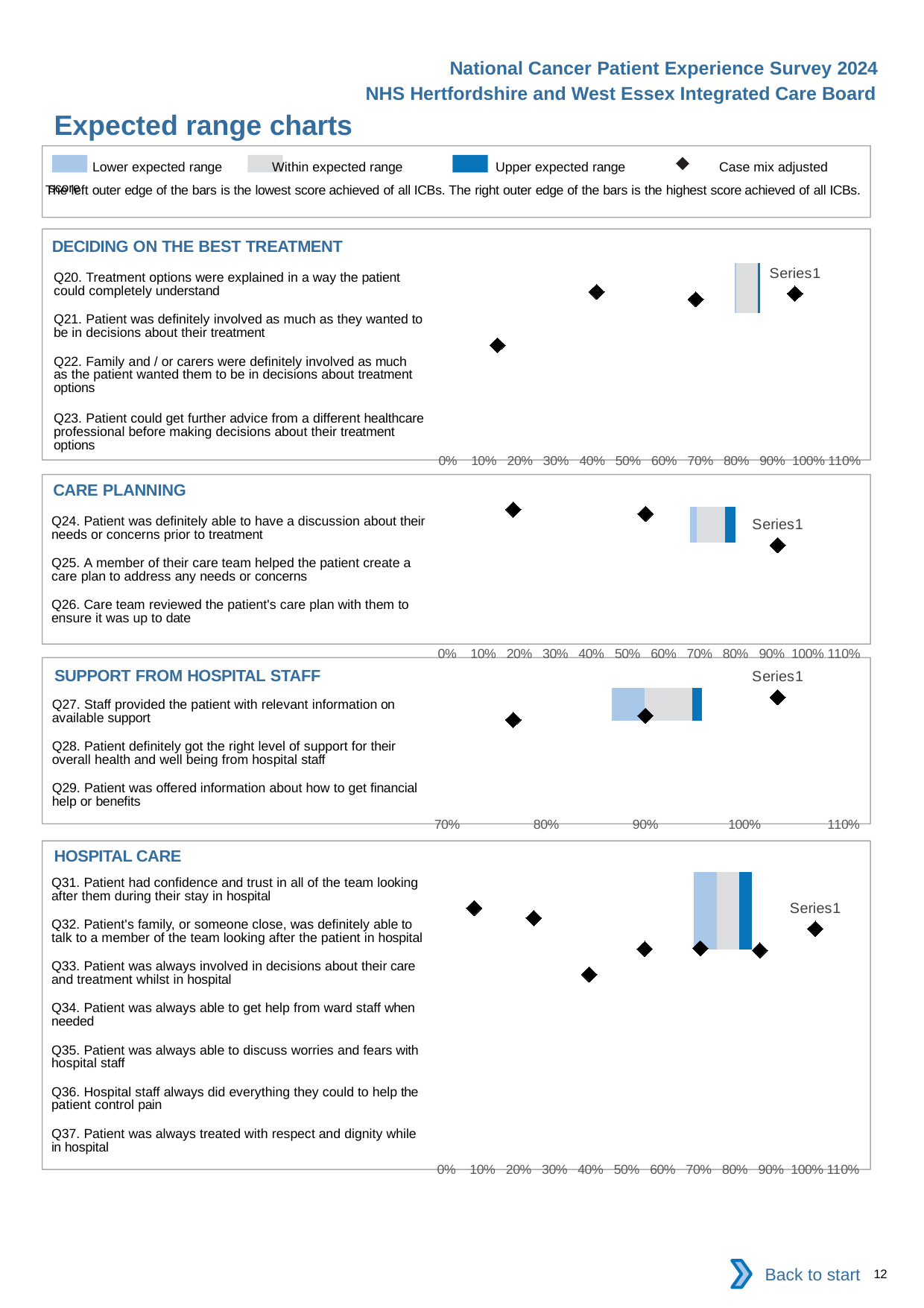
What kind of chart is used in the 'DECIDING ON THE BEST TREATMENT' section? bar chart In the 'CARE PLANNING' chart, is the left edge of the expected range bar greater or less than 50%? greater How many questions (categories) are listed in the 'SUPPORT FROM HOSPITAL STAFF' chart? 3 How many questions (categories) are listed in the 'DECIDING ON THE BEST TREATMENT' chart? 4 How many questions (categories) are listed in the 'CARE PLANNING' chart? 3 In the 'HOSPITAL CARE' chart, is the left edge of the expected range bar greater or less than 50%? greater What is the lowest value shown on the x axis of the 'SUPPORT FROM HOSPITAL STAFF' chart? 70% In the 'SUPPORT FROM HOSPITAL STAFF' chart, is the right edge of the expected range bar greater or less than 90%? greater According to the legend, what does the black diamond marker represent? Case mix adjusted score